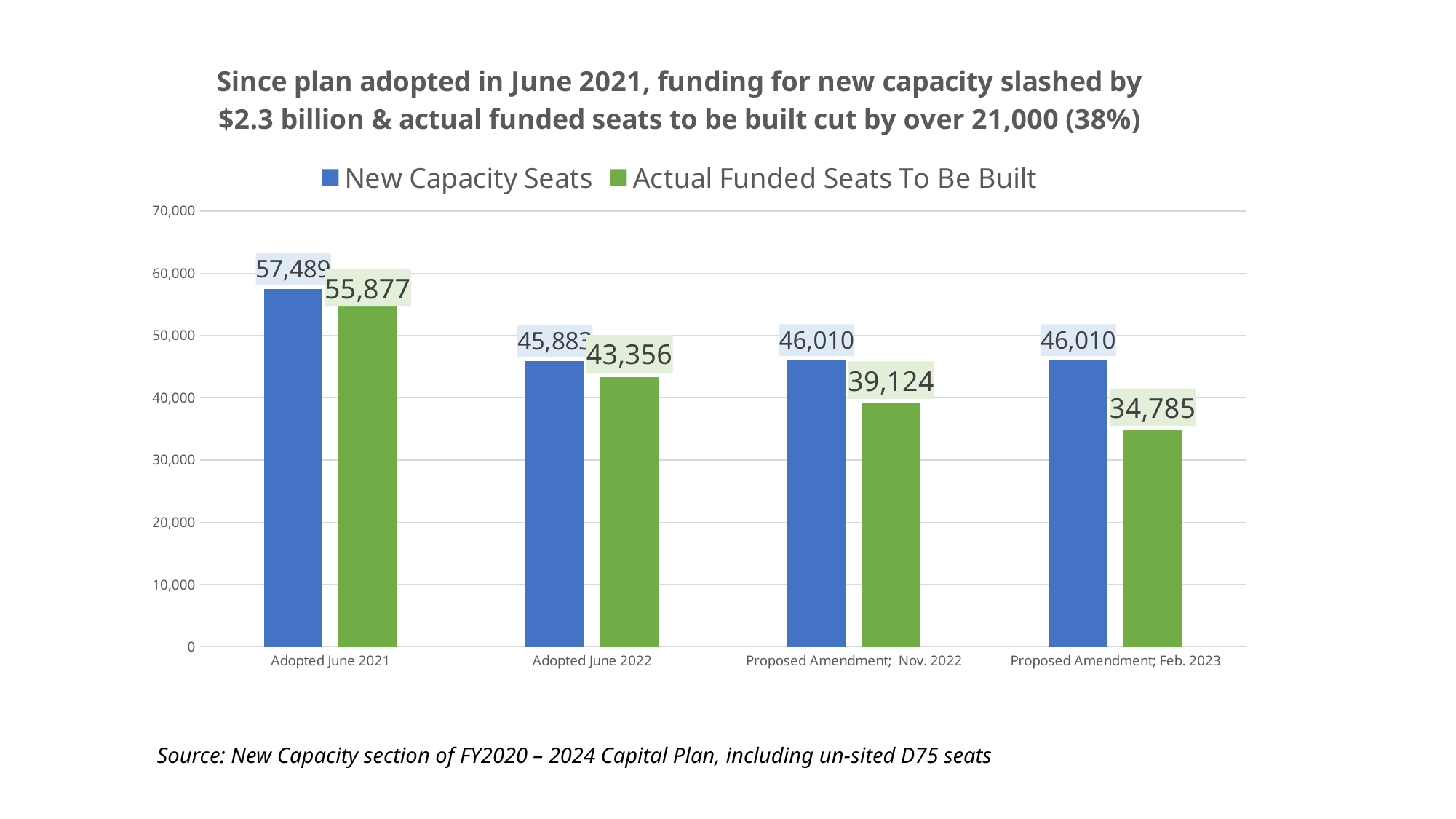
Which category has the highest value for Actual Funded Seats To Be Built? Adopted June 2021 Which colour represents the Actual Funded Seats To Be Built series? green What is the difference between New Capacity Seats and Actual Funded Seats To Be Built for Proposed Amendment; Feb. 2023? 11,225 Which category has the lowest value for Actual Funded Seats To Be Built? Proposed Amendment; Feb. 2023 How many categories are shown on the x axis? 4 Do the values for Actual Funded Seats To Be Built rise or fall across the categories from left to right? fall How many series does the legend list? 2 What kind of chart is shown on the slide? bar chart What is the value of New Capacity Seats for Proposed Amendment; Nov. 2022? 46,010 What is the value of Actual Funded Seats To Be Built for Adopted June 2022? 43,356 Is the value of Actual Funded Seats To Be Built for Proposed Amendment; Feb. 2023 greater or less than 40,000? less What is the value of Actual Funded Seats To Be Built for Proposed Amendment; Feb. 2023? 34,785